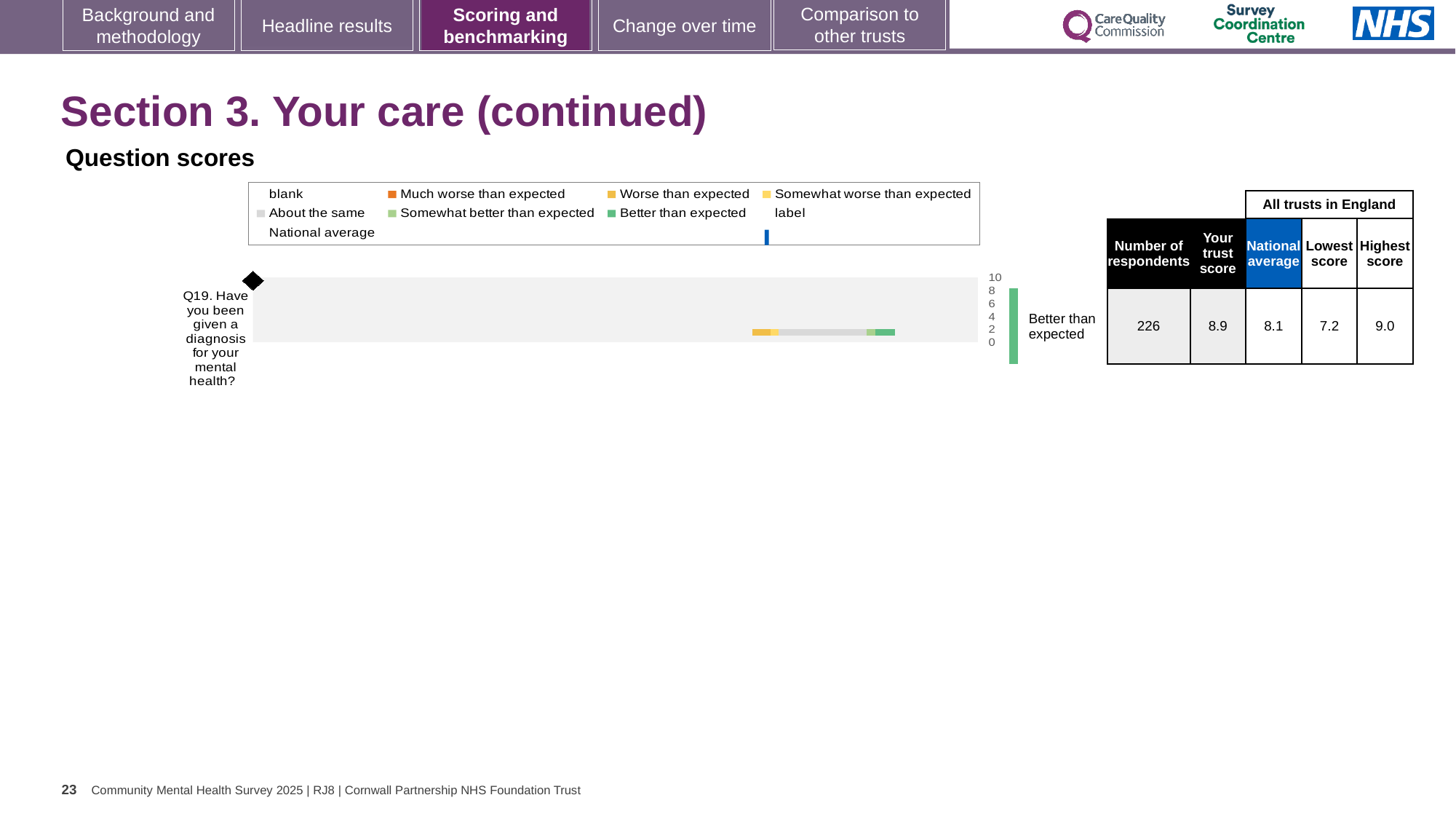
What is the difference between the highest and lowest scores for Q19? 1.8 What is the highest score among all trusts in England for Q19? 9.0 What is the lowest score among all trusts in England for Q19? 7.2 What is the difference between the trust score and the national average for Q19? 0.8 What kind of chart is used to show the Q19 question score? bar chart What is the trust score for Q19 (Have you been given a diagnosis for your mental health?)? 8.9 Is the trust score for Q19 greater or less than 8? greater What is the national average score for Q19? 8.1 How many questions are plotted on the chart? 1 What benchmarking category is shown for Q19? Better than expected How many respondents answered Q19? 226 Which is larger for Q19, the trust score or the national average? the trust score